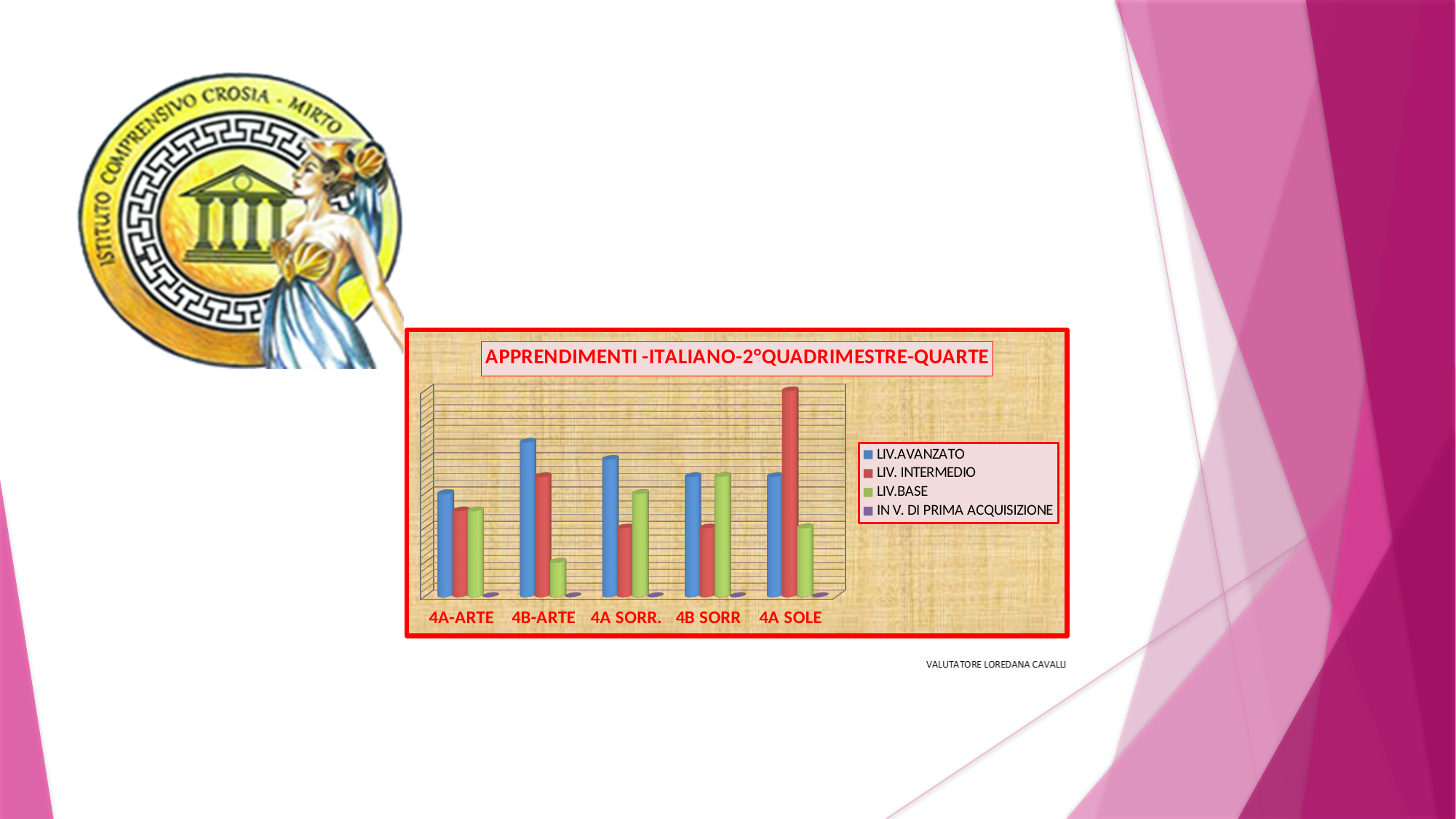
For 4A SOLE, which is larger: LIV.AVANZATO or LIV. INTERMEDIO? LIV. INTERMEDIO What is the title of the chart? APPRENDIMENTI -ITALIANO-2°QUADRIMESTRE-QUARTE For which class is the LIV. INTERMEDIO bar the highest? 4A SOLE For 4B-ARTE, which is larger: LIV.AVANZATO or LIV.BASE? LIV.AVANZATO For 4A SORR., which is larger: LIV. INTERMEDIO or LIV.BASE? LIV.BASE For which class is the LIV.BASE bar the lowest? 4B-ARTE How many categories (classes) are shown on the x axis of the chart? 5 Which series is shown in green in the chart's legend? LIV.BASE For which class is the LIV.AVANZATO bar the lowest? 4A-ARTE How many series does the chart's legend list? 4 For which class is the LIV.AVANZATO bar the highest? 4B-ARTE What kind of chart is shown on the slide? bar chart